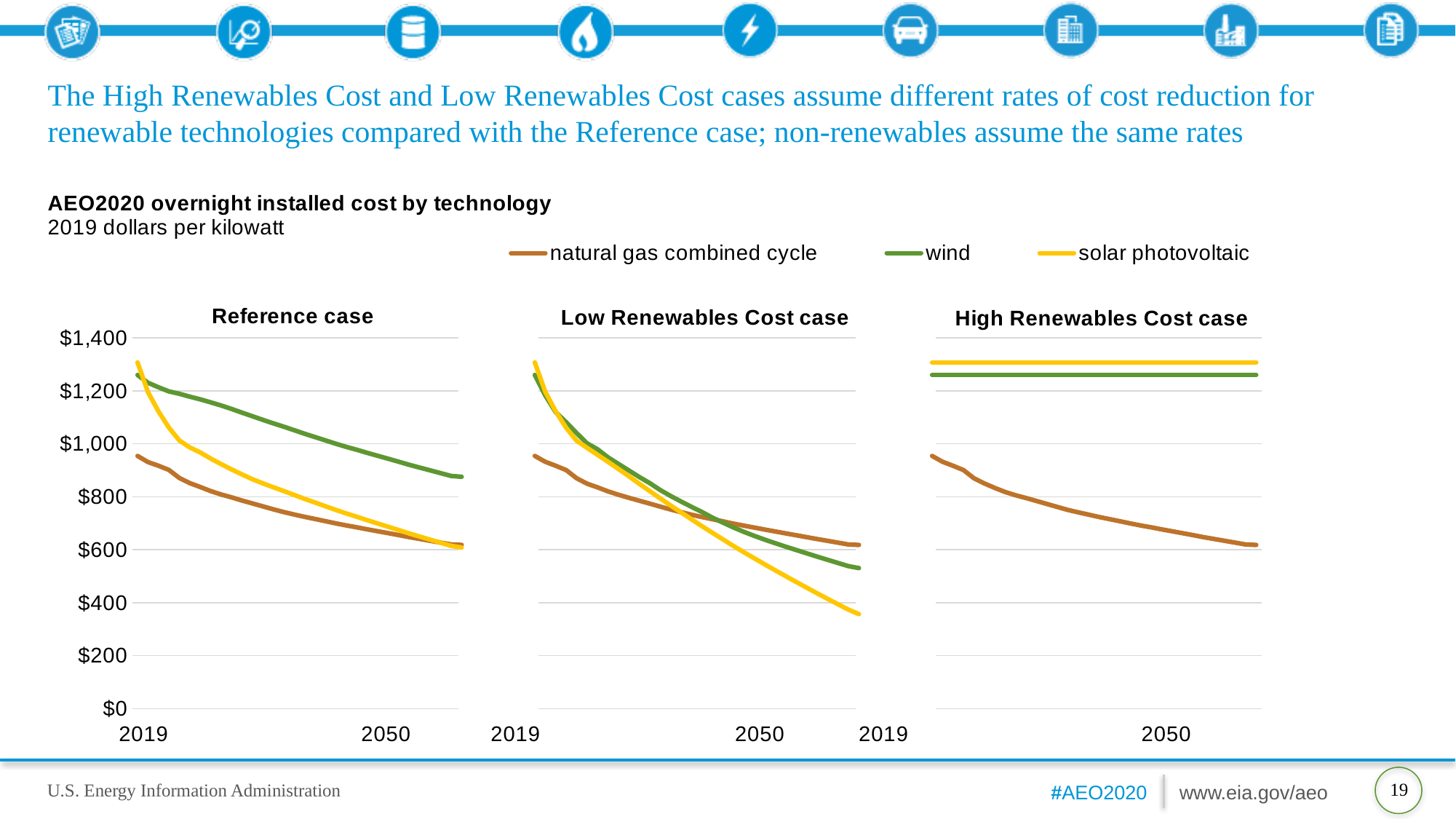
What unit is shown under the chart title? 2019 dollars per kilowatt In the High Renewables Cost case chart, does the wind series rise, fall, or stay flat from 2019 to 2050? stays flat In the Low Renewables Cost case chart, which is larger in 2050: natural gas combined cycle or solar photovoltaic? natural gas combined cycle In the High Renewables Cost case chart, is the value for solar photovoltaic greater or less than $1,200? greater What kind of chart is the Reference case chart? line chart In the Reference case chart, is the value for natural gas combined cycle in 2019 greater or less than $1,000? less In the Low Renewables Cost case chart, which series has the lowest value in 2050? solar photovoltaic In the Reference case chart, does the natural gas combined cycle series rise or fall from 2019 to 2050? fall In the Low Renewables Cost case chart, is the value for solar photovoltaic in 2050 greater or less than $400? less In the Reference case chart, which series has the highest value in 2050? wind How many series does the legend list? 3